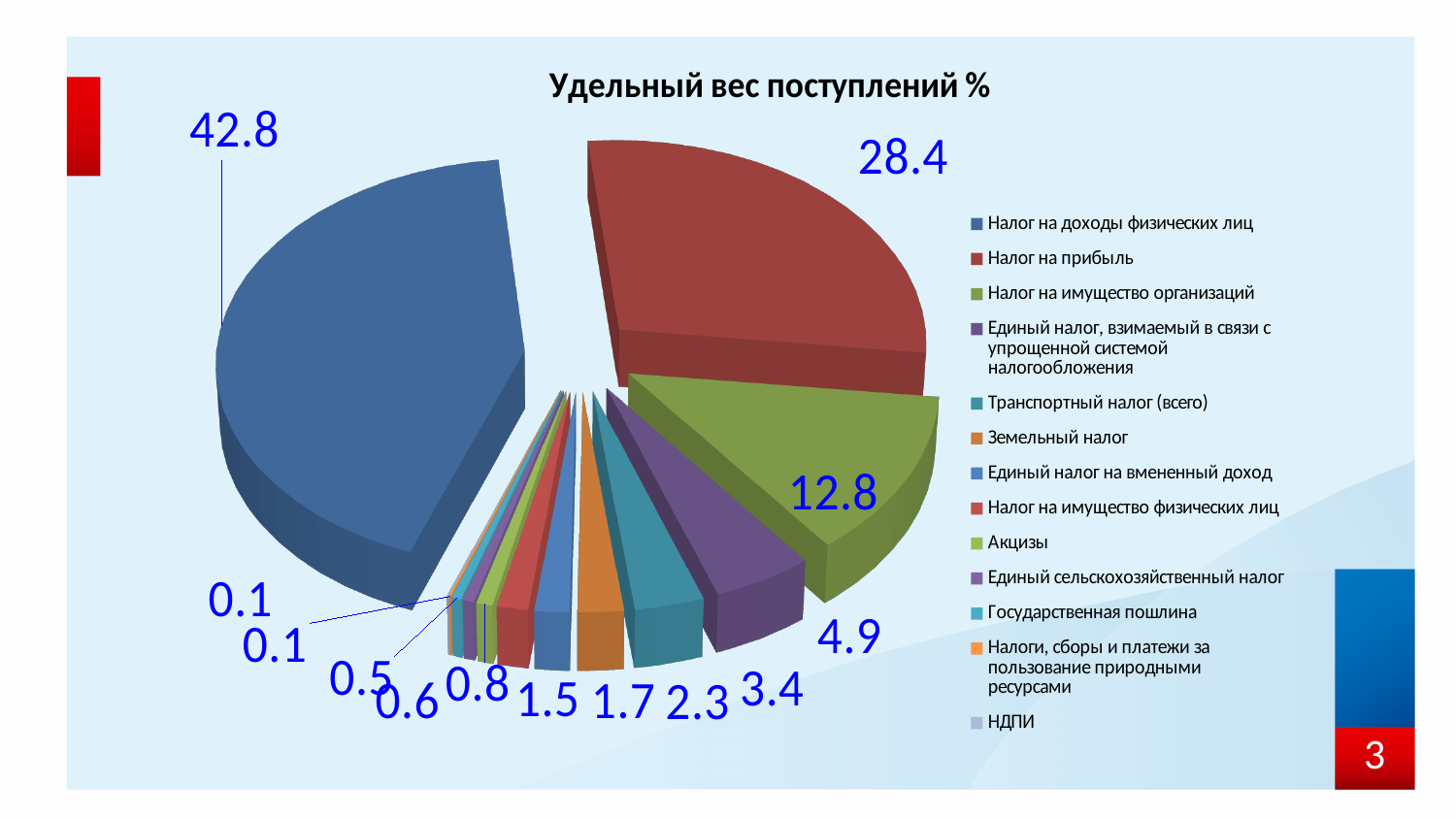
How many entries does the chart legend list? 13 What is the largest value labelled on the chart? 42.8 What kind of chart is shown on the slide? pie chart What is the value shown for Налог на доходы физических лиц? 42.8 What is the value shown for Налог на прибыль? 28.4 Which category has the largest share of the pie? Налог на доходы физических лиц What is the title of the chart? Удельный вес поступлений % Which is larger: Налог на прибыль or Налог на имущество организаций? Налог на прибыль What is the value shown for Налог на имущество организаций? 12.8 What colour is the slice for Налог на прибыль? red What is the smallest value labelled on the chart? 0.1 What is the difference between the values for Налог на доходы физических лиц and Налог на прибыль? 14.4